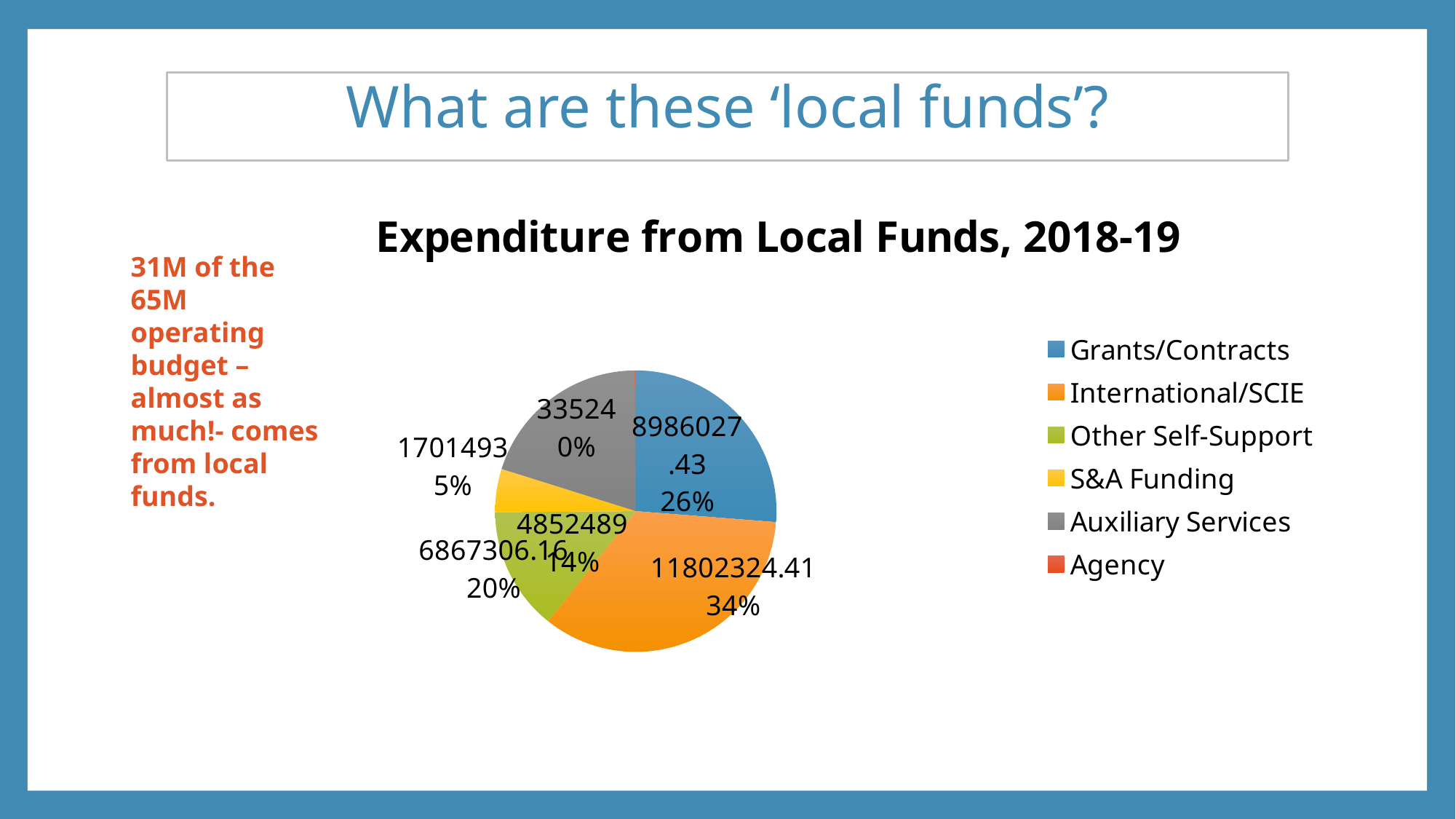
Which is larger, the share for Grants/Contracts or the share for Other Self-Support? Grants/Contracts How many categories does the legend of the pie chart list? 6 What percentage share does International/SCIE have? 34% Which category has the smallest share of the pie? Agency What is the value shown for S&A Funding? 1701493 What kind of chart is shown on the slide? pie chart What is the title of the chart? Expenditure from Local Funds, 2018-19 Which category has the largest share of the pie? International/SCIE What percentage share does Grants/Contracts have? 26% What is the difference in percentage points between the International/SCIE share and the Grants/Contracts share? 8% What is the value shown for International/SCIE? 11802324.41 What percentage share does Other Self-Support have? 14%